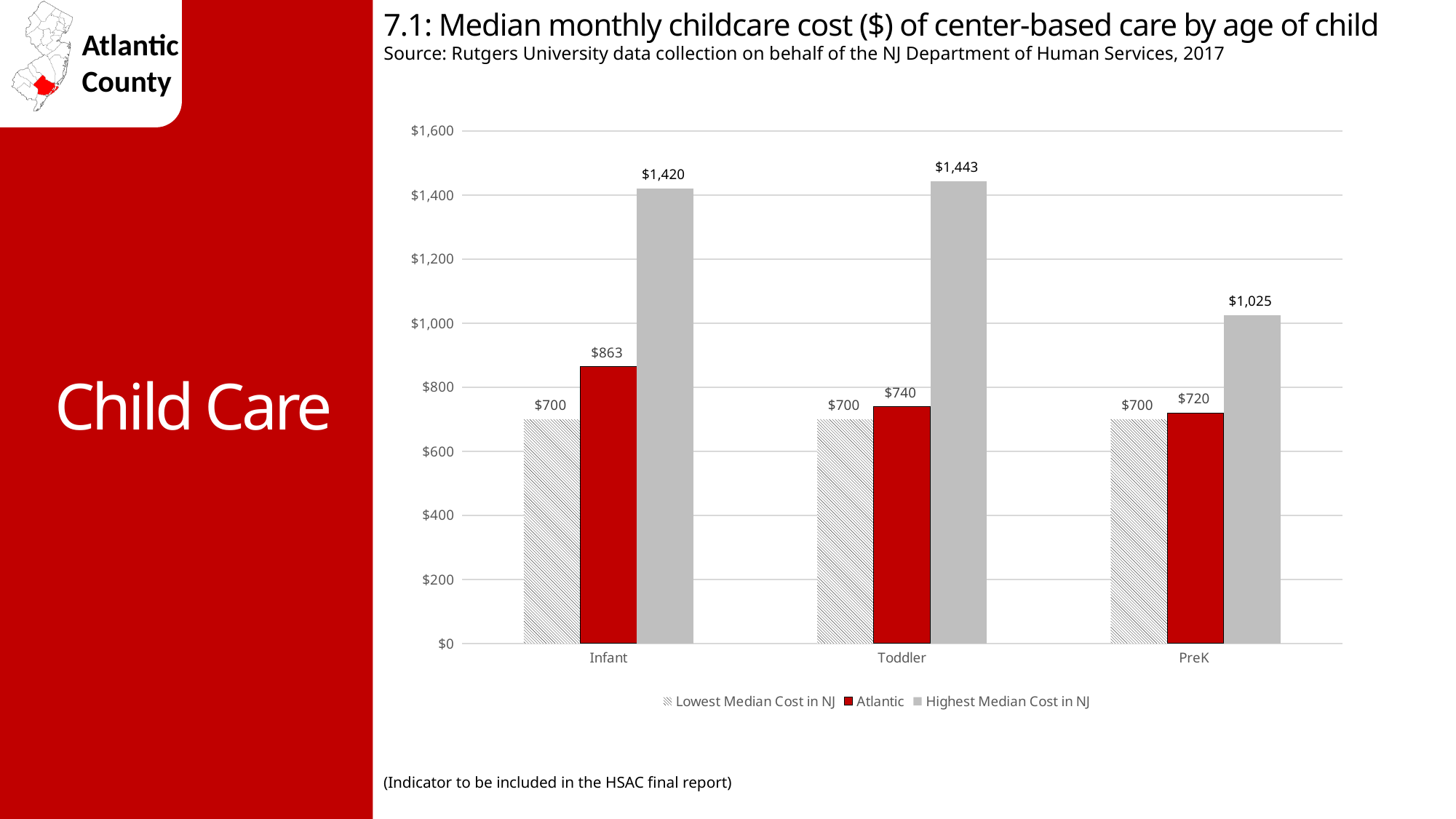
What is the difference between the Highest Median Cost in NJ and the Atlantic cost for Infant care? $557 What kind of chart is shown on the slide? Bar chart Which age group has the highest Atlantic median monthly cost? Infant Which is larger, the Highest Median Cost in NJ for Infant or for Toddler? Toddler What is the Lowest Median Cost in NJ for PreK care? $700 What is the Atlantic value for PreK? $720 Which age group has the lowest Highest Median Cost in NJ? PreK What is the median monthly childcare cost for Atlantic for Infant care? $863 How many age groups are shown on the x axis? 3 How many series does the legend list? 3 What is the Highest Median Cost in NJ for Toddler care? $1,443 What is the difference between the Atlantic cost and the Lowest Median Cost in NJ for Toddler care? $40